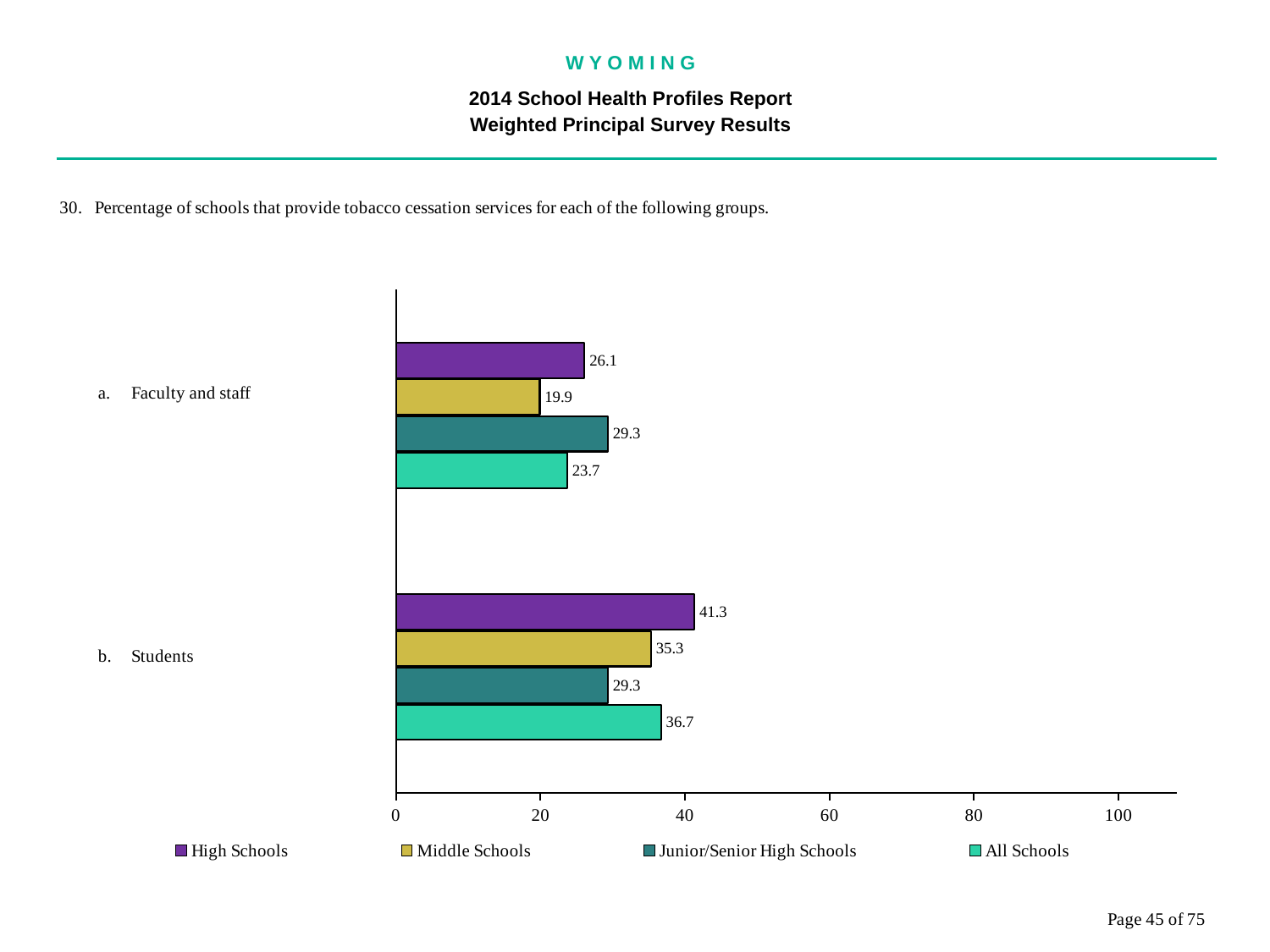
How many categories are shown on the chart? 2 How many series does the legend list? 4 What is the difference between the High Schools value and the Middle Schools value in the Students category? 6.0 Which series has the lowest value in the Faculty and staff category? Middle Schools What kind of chart is shown on the slide? bar chart Is the value for Junior/Senior High Schools in the Faculty and staff category greater or less than 20? greater Which series has the highest value in the Students category? High Schools What is the maximum value shown on the x axis? 100 What is the value for High Schools in the Faculty and staff category? 26.1 What is the value for All Schools in the Faculty and staff category? 23.7 Which is larger: the All Schools value for Students or the All Schools value for Faculty and staff? Students What is the value for Middle Schools in the Students category? 35.3